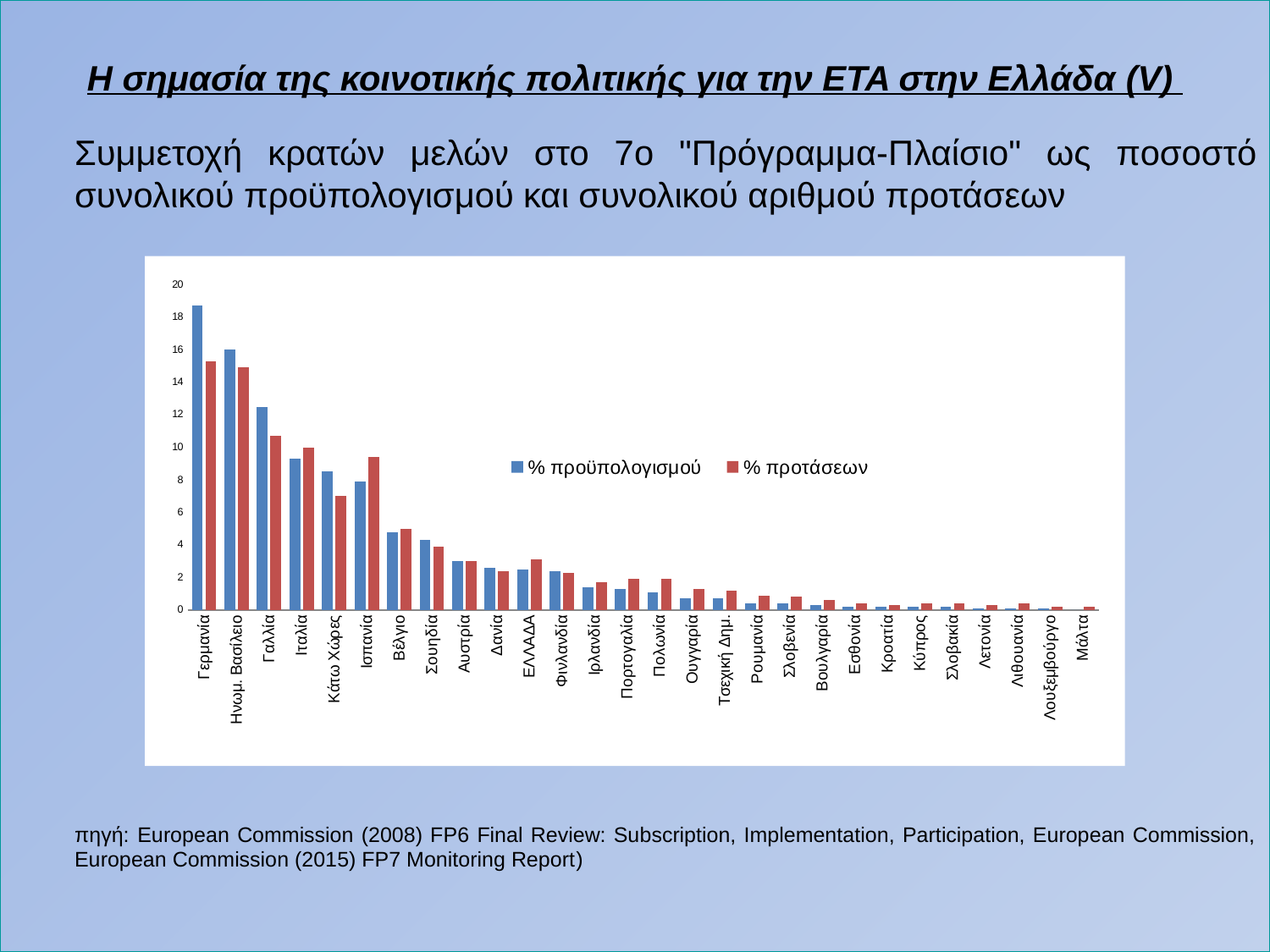
Is the % προτάσεων value for Ισπανία greater or less than 8? greater How many series does the legend list? 2 What kind of chart is shown on the slide? bar chart Do the % προϋπολογισμού values generally rise or fall from left to right along the x axis? fall What are the two series named in the legend? % προϋπολογισμού and % προτάσεων For Κάτω Χώρες, which is larger: % προϋπολογισμού or % προτάσεων? % προϋπολογισμού Which country has the highest value for % προϋπολογισμού? Γερμανία How many countries are shown on the x axis? 28 Is the % προϋπολογισμού value for Ιταλία greater or less than 10? less Is the % προϋπολογισμού value for Γερμανία greater or less than 18? greater Which country has the highest value for % προτάσεων? Γερμανία